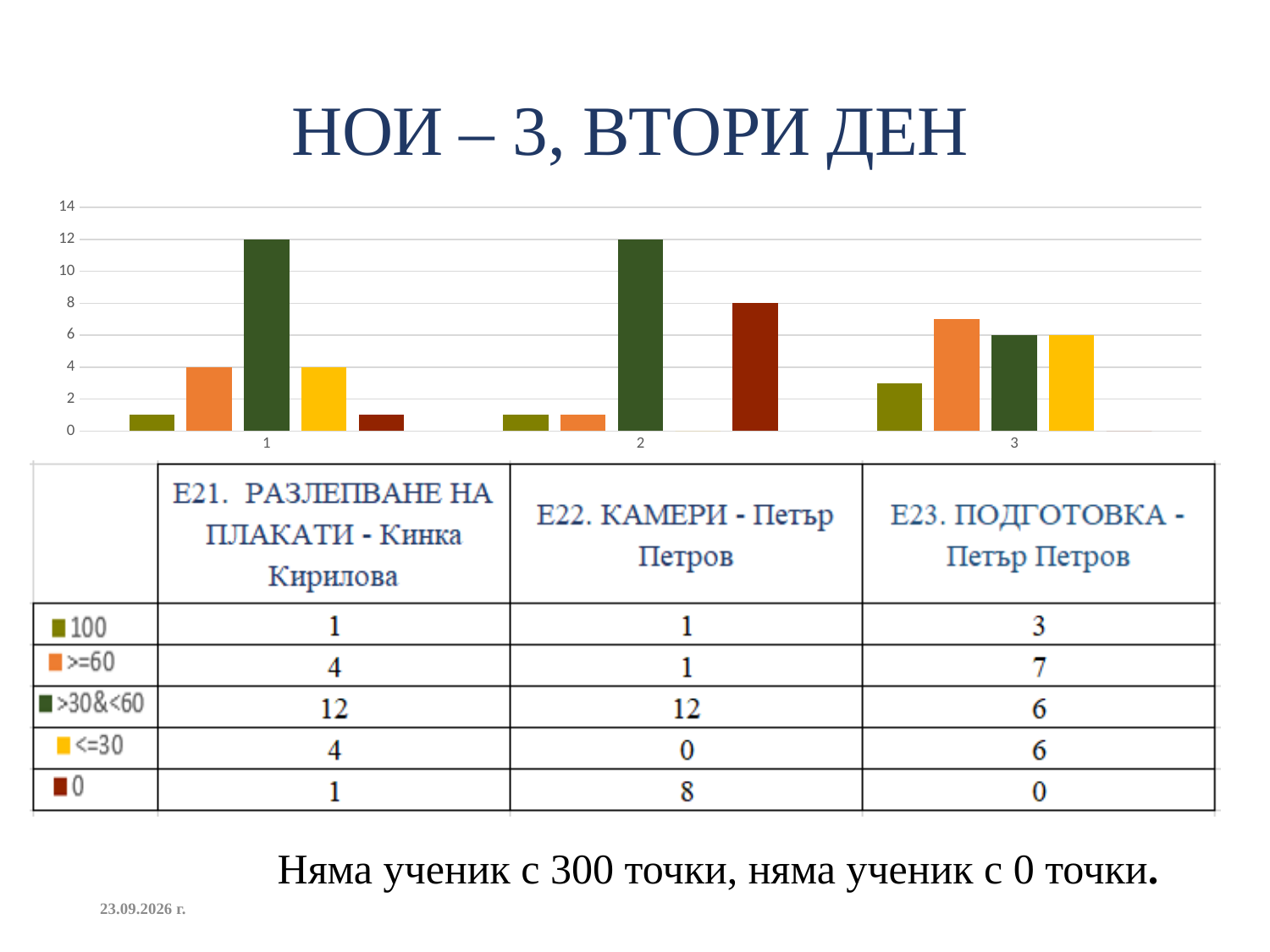
Which is larger for E22 (category 2): the ">30&<60" value or the "0" value? >30&<60 What is the total of all five series values for E21 (category 1)? 22 How many categories are shown on the x axis of the chart? 3 Which series has the lowest value for E23 (category 3)? 0 How many series does the legend (data table) list? 5 What is the difference between the ">30&<60" value and the "<=30" value for E23 (category 3)? 0 What is the value of the "0" series for E22 (category 2)? 8 What is the value of the "<=30" series for E22 (category 2)? 0 What is the value of the ">=60" series for E23 (category 3)? 7 Which series has the highest value for E21 (category 1)? >30&<60 What kind of chart is shown on the slide? bar chart What is the value of the ">30&<60" series for E21 (category 1)? 12